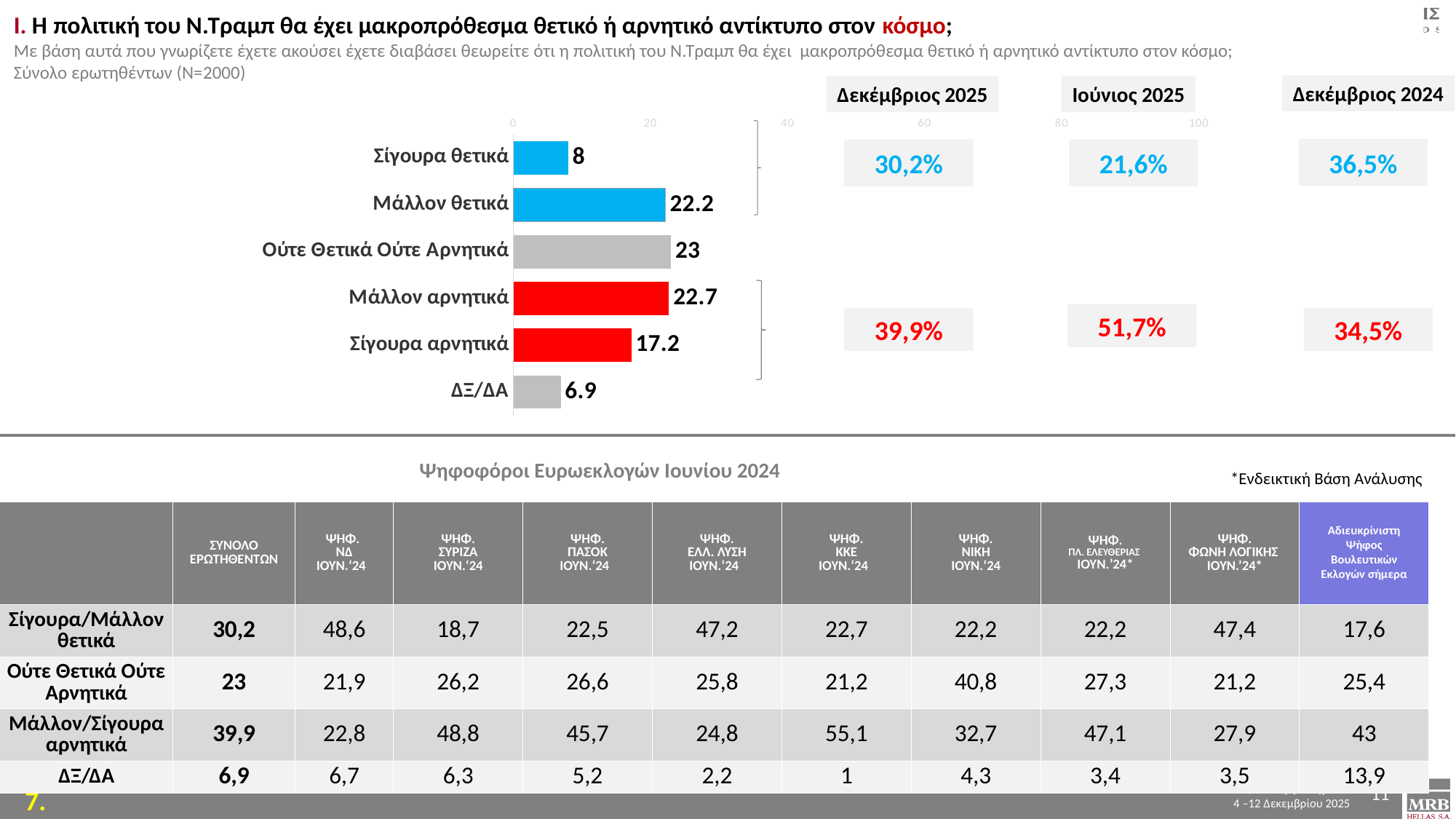
What is the value for Μάλλον αρνητικά in the bar chart? 22.7 What is the value for Ούτε Θετικά Ούτε Αρνητικά in the bar chart? 23 What is the value for Σίγουρα θετικά in the bar chart? 8 What kind of chart is shown on the slide? bar chart Which category has the highest value in the bar chart? Ούτε Θετικά Ούτε Αρνητικά What is the value for Σίγουρα αρνητικά in the bar chart? 17.2 Which is larger in the bar chart: Σίγουρα θετικά or Σίγουρα αρνητικά? Σίγουρα αρνητικά What is the value for ΔΞ/ΔΑ in the bar chart? 6.9 Which category has the lowest value in the bar chart? ΔΞ/ΔΑ What is the value for Μάλλον θετικά in the bar chart? 22.2 How many categories are shown in the bar chart? 6 What is the difference between the values for Μάλλον αρνητικά and Σίγουρα αρνητικά in the bar chart? 5.5